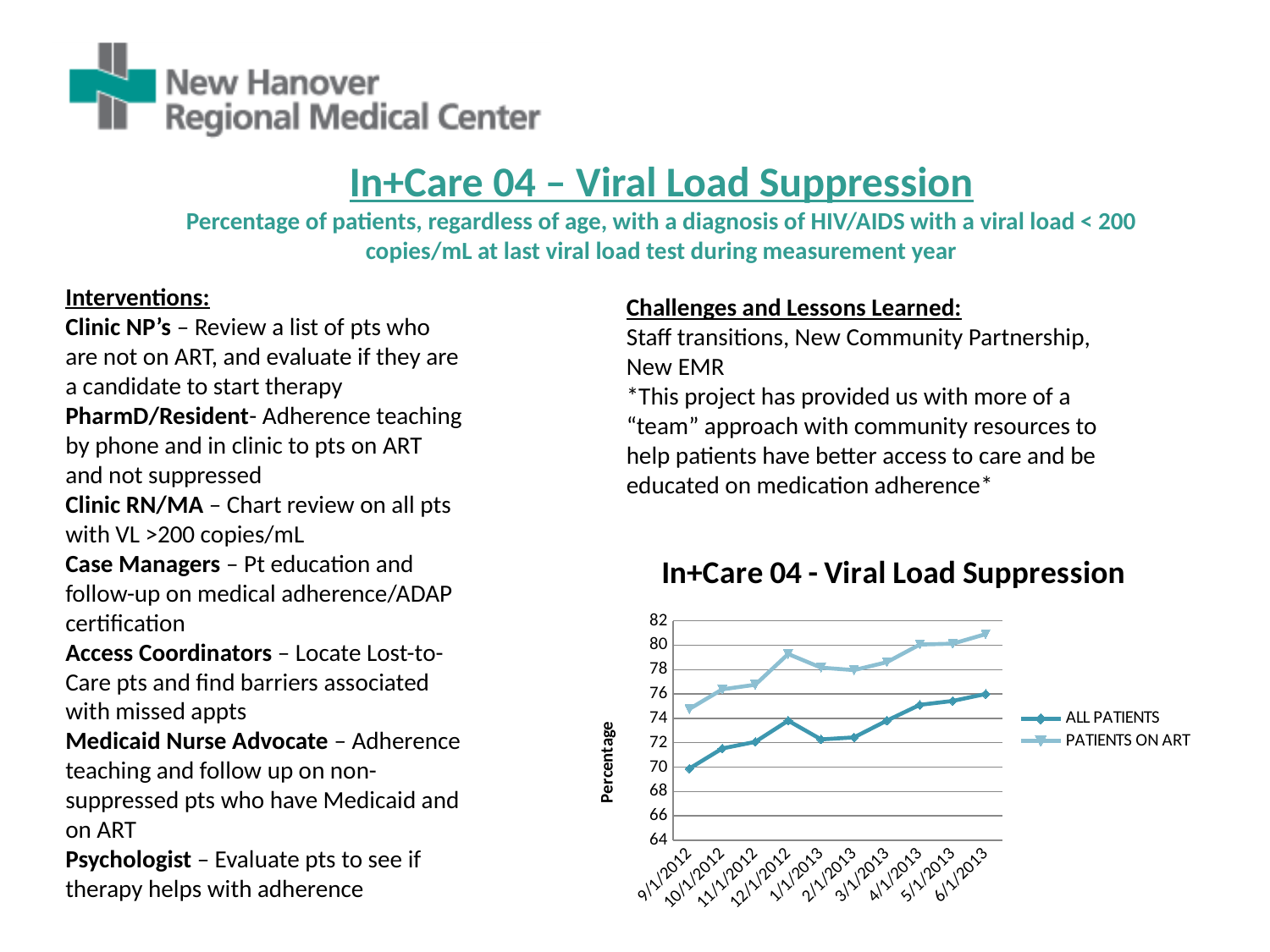
What type of chart is shown on the slide? Line chart Is the value for ALL PATIENTS at 9/1/2012 greater or less than 72? less Is the value for PATIENTS ON ART at 9/1/2012 greater or less than 76? less How many dates are plotted along the x axis of the chart? 10 What is the label on the vertical axis of the chart? Percentage At which date is the ALL PATIENTS series at its lowest? 9/1/2012 At which date is the PATIENTS ON ART series at its highest? 6/1/2013 Is the value for PATIENTS ON ART at 6/1/2013 greater or less than 80? greater How many series does the chart legend list? 2 At 12/1/2012, which series has the higher value, ALL PATIENTS or PATIENTS ON ART? PATIENTS ON ART What is the title of the chart? In+Care 04 - Viral Load Suppression